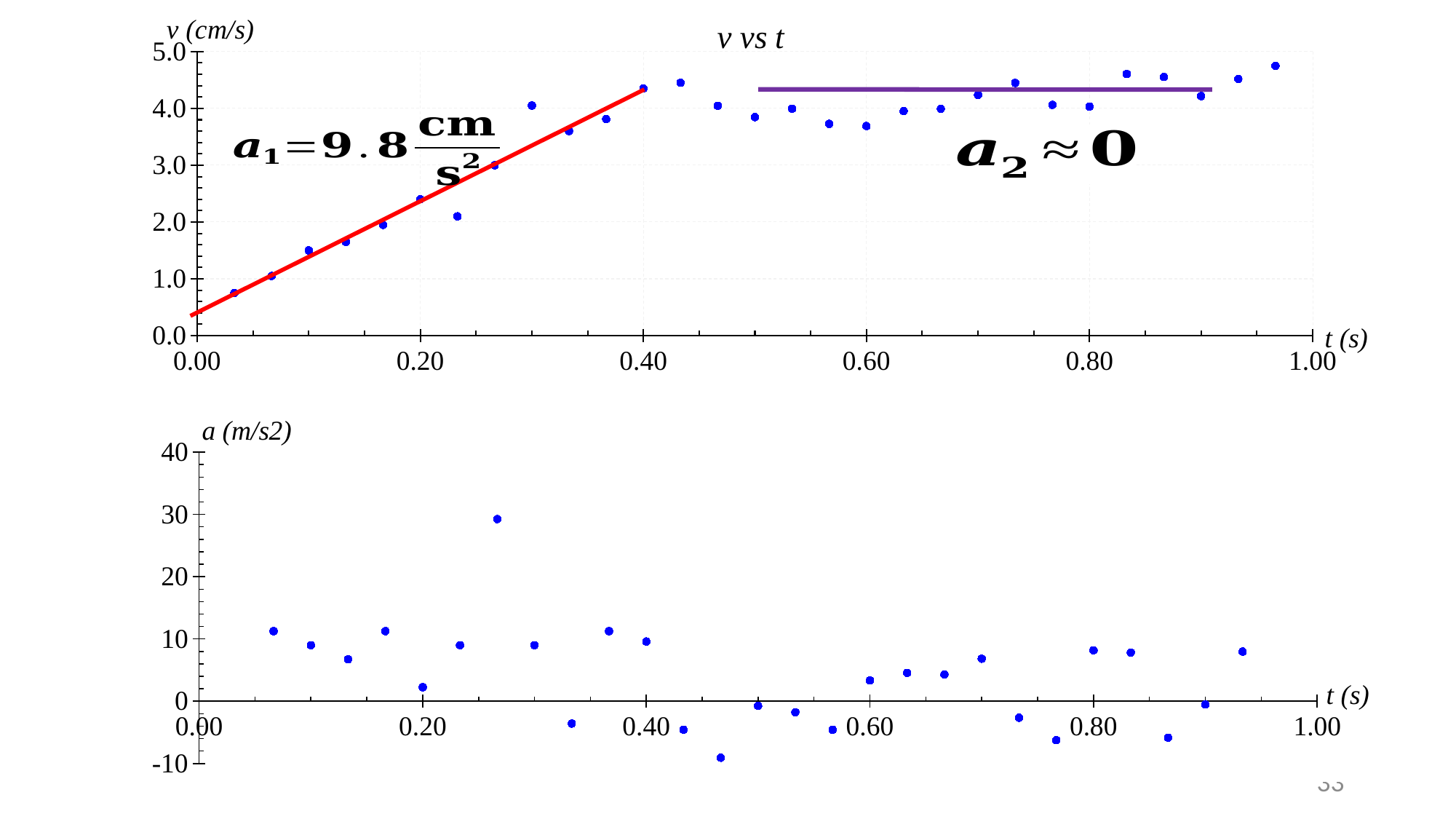
In the top chart 'v vs t', is the value at t = 0.40 greater or less than 4.0? greater What is the title of the top chart? v vs t In the top chart 'v vs t', is the value at t = 0.20 greater or less than 2.0? greater In the top chart 'v vs t', do the values rise or fall along the x axis between t = 0.00 and t = 0.40? rise In the bottom chart (a vs t), is the lowest point greater or less than 0? less What kind of chart is the top chart titled 'v vs t'? scatter chart What is the y-axis label of the bottom chart? a (m/s2) In the top chart 'v vs t', which is larger, the value at t = 0.20 or the value at t = 0.40? t = 0.40 What kind of chart is the bottom chart (a vs t)? scatter chart